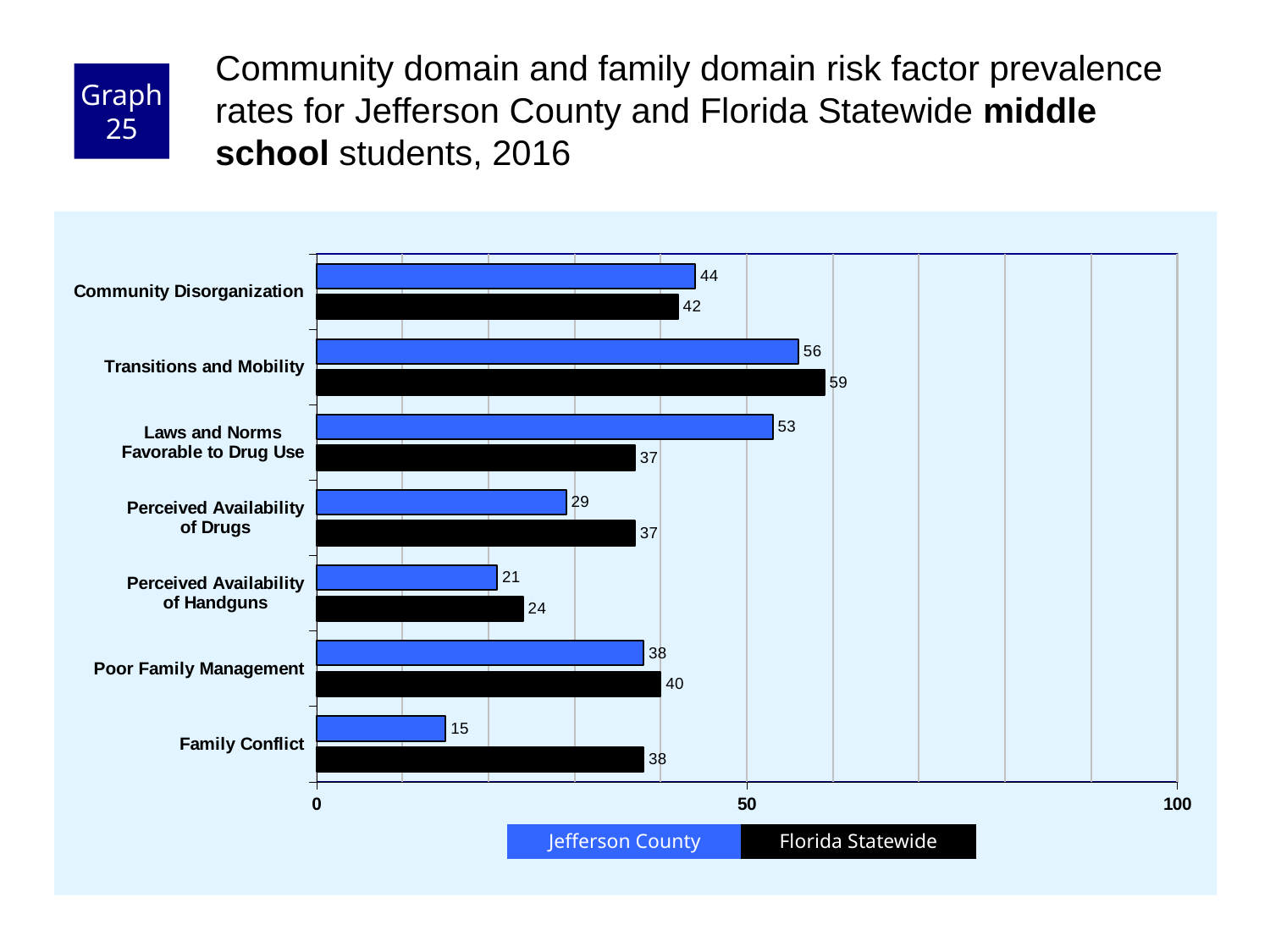
What is the Jefferson County value for Transitions and Mobility? 56 What is the Jefferson County value for Perceived Availability of Handguns? 21 What is the difference between the Jefferson County and Florida Statewide values for Laws and Norms Favorable to Drug Use? 16 How many risk factor categories are shown on the chart? 7 Which is larger for Perceived Availability of Drugs: the Jefferson County value or the Florida Statewide value? Florida Statewide Which risk factor has the highest Florida Statewide value? Transitions and Mobility What is the difference between the Florida Statewide and Jefferson County values for Family Conflict? 23 What is the Florida Statewide value for Family Conflict? 38 What kind of chart is shown on the slide? bar chart How many series does the legend list? 2 Is the Florida Statewide value for Transitions and Mobility greater or less than 50? greater Which risk factor has the lowest Jefferson County value? Family Conflict